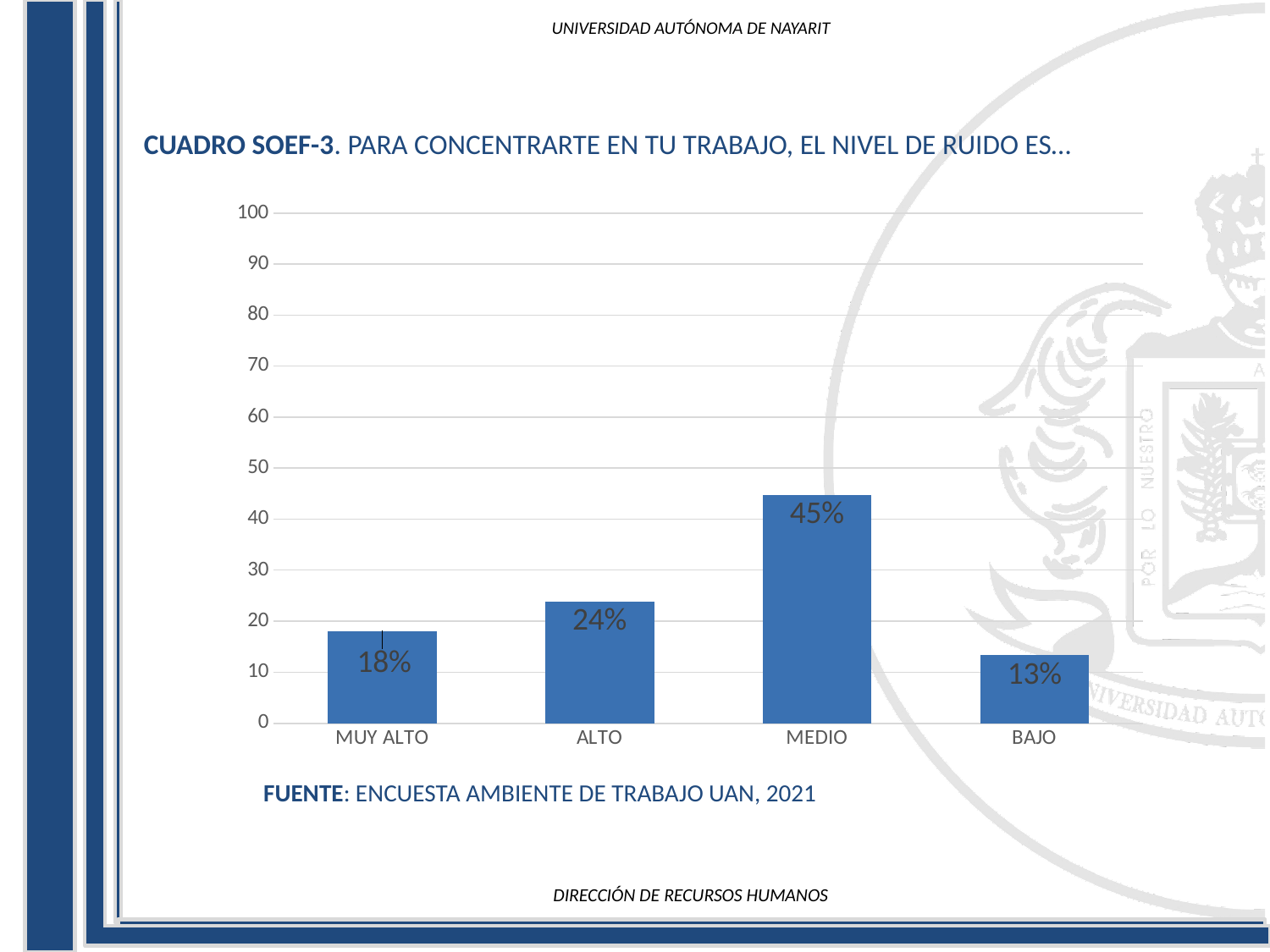
What kind of chart is shown on the slide? bar chart What is the source cited below the chart? ENCUESTA AMBIENTE DE TRABAJO UAN, 2021 What is the difference between the values for MEDIO and ALTO? 21% What is the value for MEDIO? 45% Which category has the lowest value? BAJO What is the value for MUY ALTO? 18% Which is larger, the value for ALTO or the value for MUY ALTO? ALTO What is the highest value shown on the y axis? 100 Is the value for MEDIO greater or less than 50? less Which category has the highest value? MEDIO How many categories are shown on the x axis? 4 What is the value for BAJO? 13%